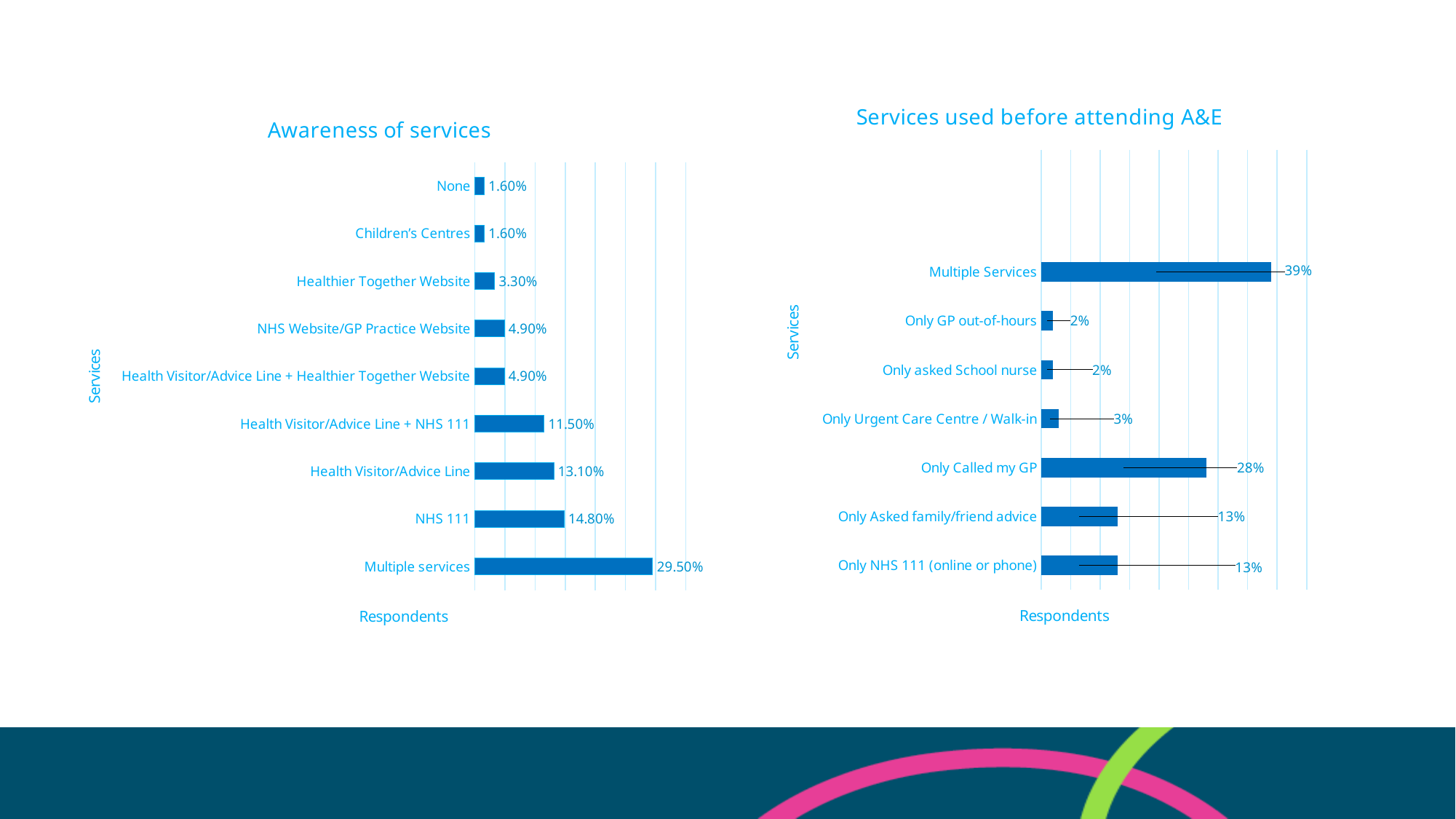
What is the x-axis label of the 'Awareness of services' chart? Respondents In the 'Services used before attending A&E' chart, which category has the highest value? Multiple Services In the 'Services used before attending A&E' chart, what is the value for Only Called my GP? 28% In the 'Awareness of services' chart, what is the value for Healthier Together Website? 3.30% In the 'Awareness of services' chart, which is larger: Health Visitor/Advice Line or Health Visitor/Advice Line + NHS 111? Health Visitor/Advice Line In the 'Awareness of services' chart, what is the difference between Multiple services and NHS 111? 14.70% In the 'Awareness of services' chart, what is the value for NHS 111? 14.80% In the 'Services used before attending A&E' chart, what is the difference between Multiple Services and Only Called my GP? 11% In the 'Services used before attending A&E' chart, how many categories are shown? 7 In the 'Awareness of services' chart, which category has the highest value? Multiple services What type of chart is the 'Services used before attending A&E' chart? Bar chart In the 'Awareness of services' chart, how many categories are shown? 9